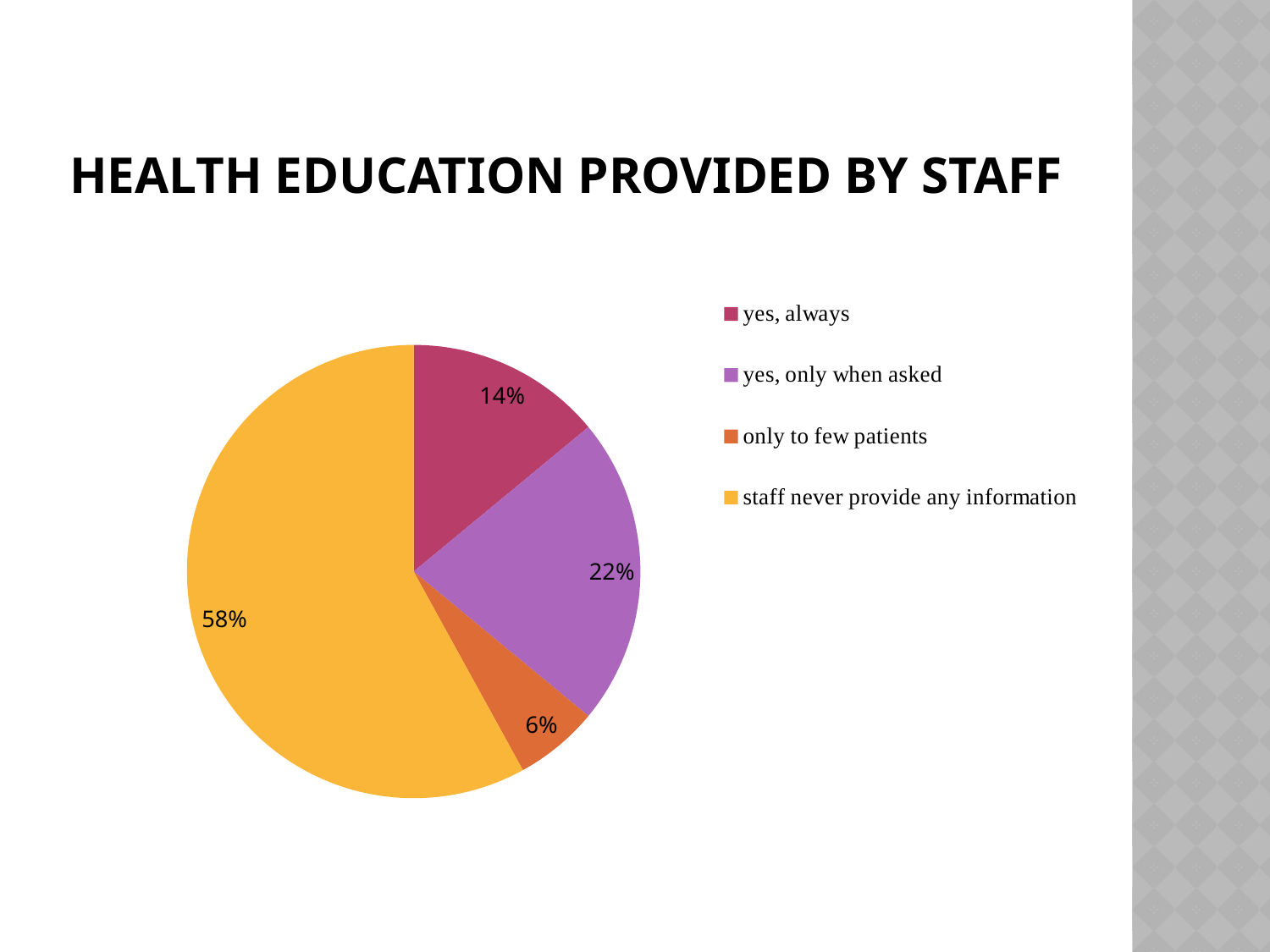
Which is larger, the share for 'yes, always' or the share for 'yes, only when asked'? yes, only when asked What percentage of the pie is 'staff never provide any information'? 58% What percentage of the pie is 'only to few patients'? 6% What percentage of the pie is 'yes, always'? 14% What colour is the slice for 'yes, always'? dark red Which category has the smallest share of the pie? only to few patients What is the title of the slide? HEALTH EDUCATION PROVIDED BY STAFF What kind of chart is shown on the slide? pie chart What percentage of the pie is 'yes, only when asked'? 22% Which category has the largest share of the pie? staff never provide any information What is the difference in percentage points between 'staff never provide any information' and 'yes, only when asked'? 36 How many categories does the pie chart have? 4